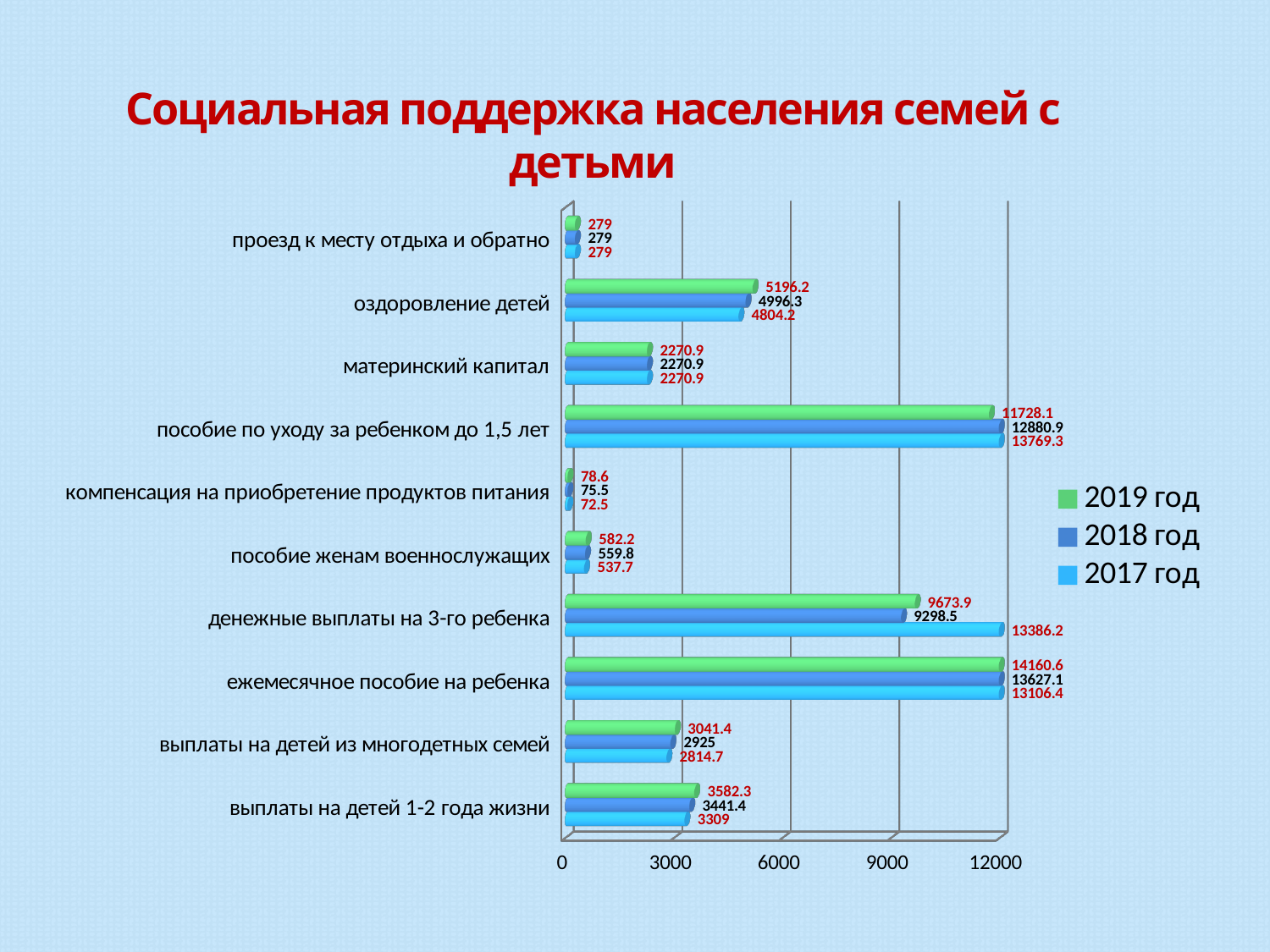
What is the value for 2017 год for денежные выплаты на 3-го ребенка? 13386.2 How many categories are shown on the chart? 10 What is the difference between the 2019 год and 2017 год values for оздоровление детей? 392 Is the 2019 год value for денежные выплаты на 3-го ребенка greater or less than 9000? greater What kind of chart is shown on the slide? bar chart Which category has the highest value for 2019 год? ежемесячное пособие на ребенка What is the value for 2019 год for оздоровление детей? 5196.2 What is the value for 2018 год for выплаты на детей из многодетных семей? 2925 Which category has the lowest value for 2017 год? компенсация на приобретение продуктов питания What is the title of the slide? Социальная поддержка населения семей с детьми How many series does the legend list? 3 For пособие по уходу за ребенком до 1,5 лет, which is larger: the 2017 год value or the 2019 год value? 2017 год